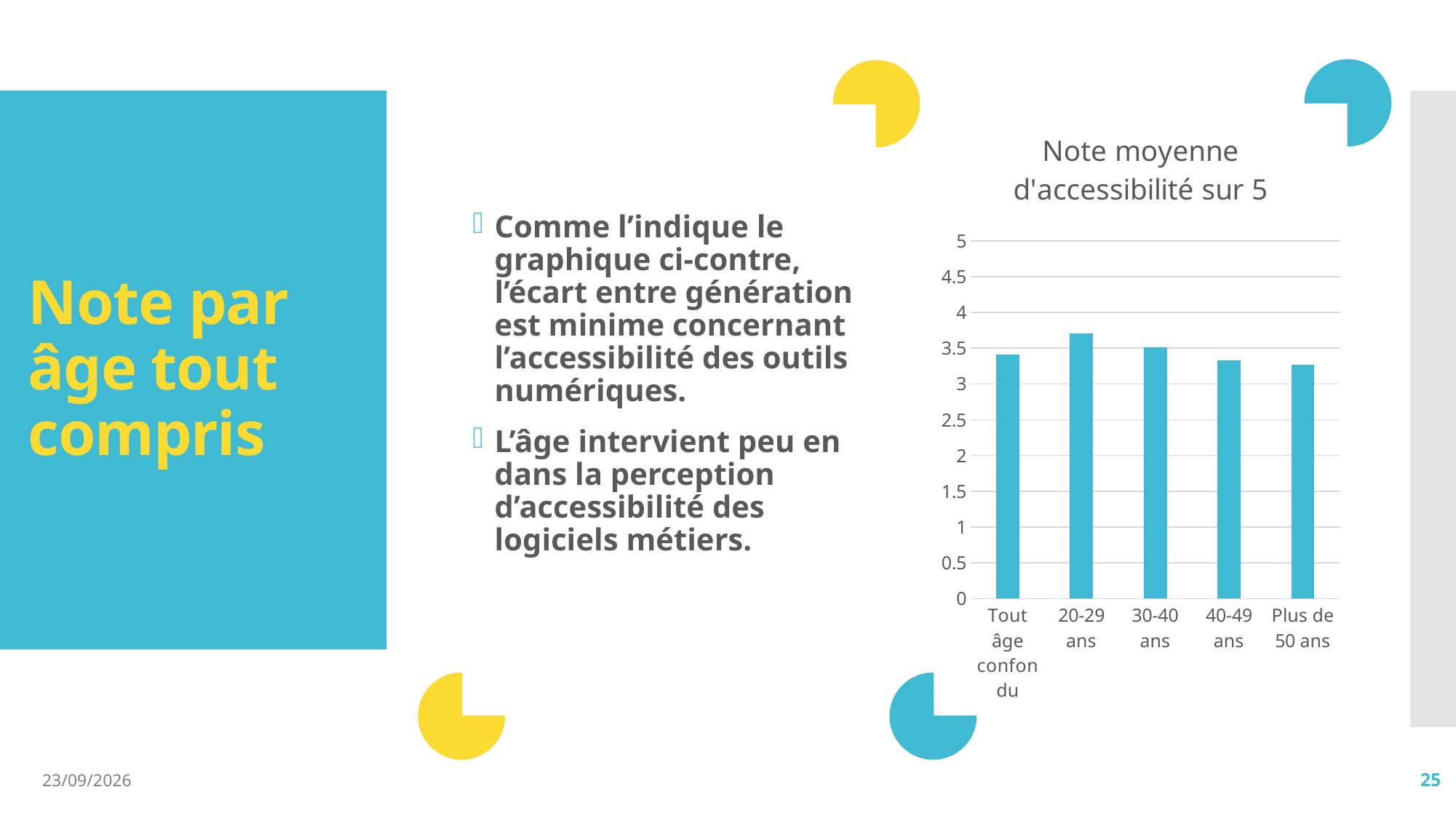
Which is larger, the value for 20-29 ans or the value for Plus de 50 ans? 20-29 ans Which category has the highest average accessibility score? 20-29 ans What kind of chart is shown on the slide? Bar chart Is the value for 40-49 ans greater or less than 3? greater Is the value for Tout âge confondu greater or less than 4? less What is the maximum value shown on the vertical axis of the chart? 5 How many age categories are shown on the x axis of the chart? 5 Is the value for 20-29 ans greater or less than 3.5? greater Do the values rise or fall across the age groups from 20-29 ans to Plus de 50 ans? fall What is the title of the chart? Note moyenne d'accessibilité sur 5 Which is larger, the value for 20-29 ans or the value for 30-40 ans? 20-29 ans